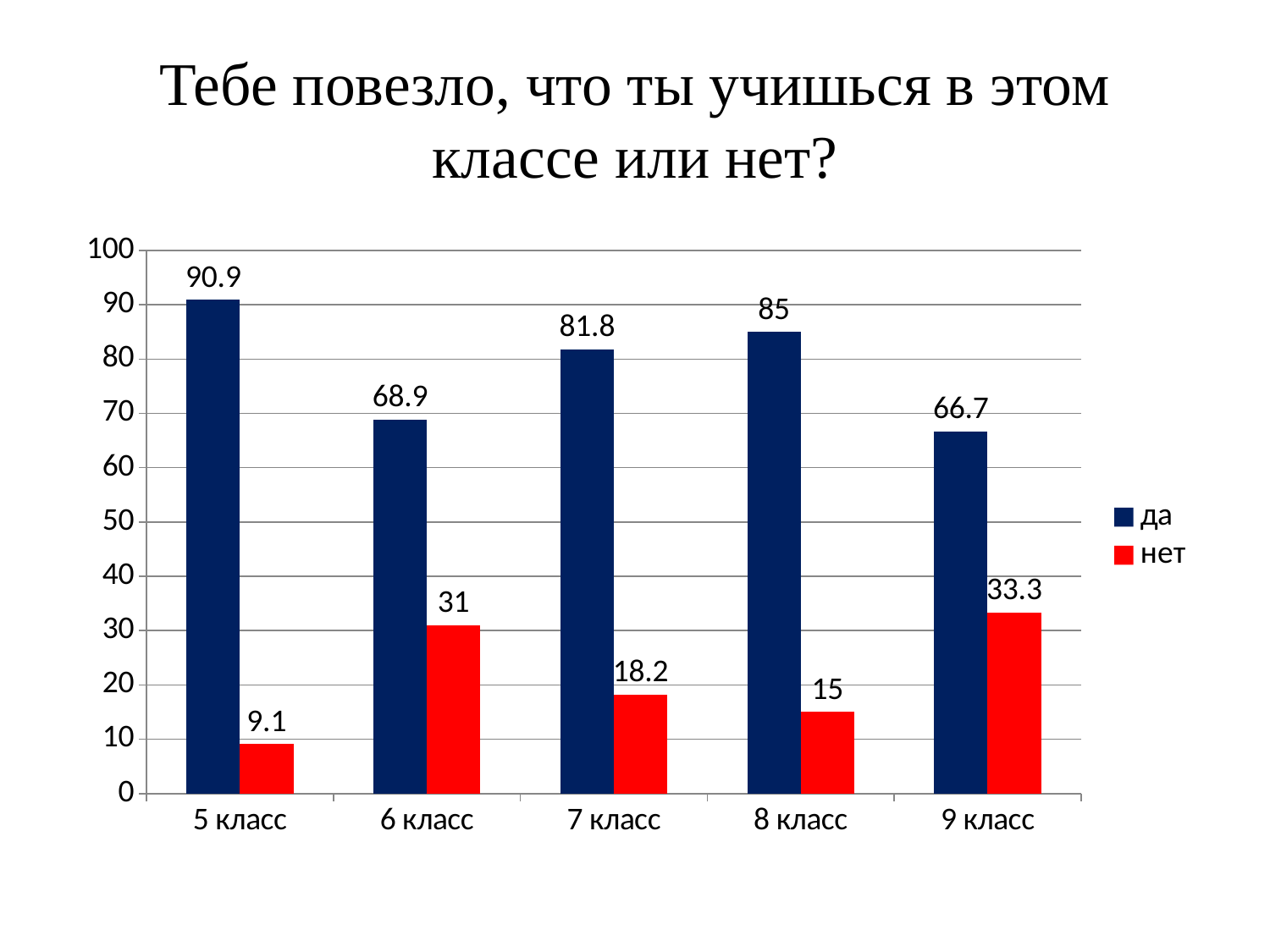
What is the value for "нет" for 7 класс? 18.2 How many series does the legend list? 2 How many classes are shown on the x axis? 5 What is the value for "да" for 5 класс? 90.9 What is the value for "нет" for 9 класс? 33.3 Is the value for "да" for 9 класс greater or less than 70? less What colour are the bars for the "нет" series? red What is the difference between the "да" and "нет" values for 8 класс? 70 Which is larger: the "нет" value for 6 класс or the "нет" value for 9 класс? 9 класс What kind of chart is shown on the slide? bar chart Which class has the lowest value for "нет"? 5 класс Which class has the highest value for "да"? 5 класс